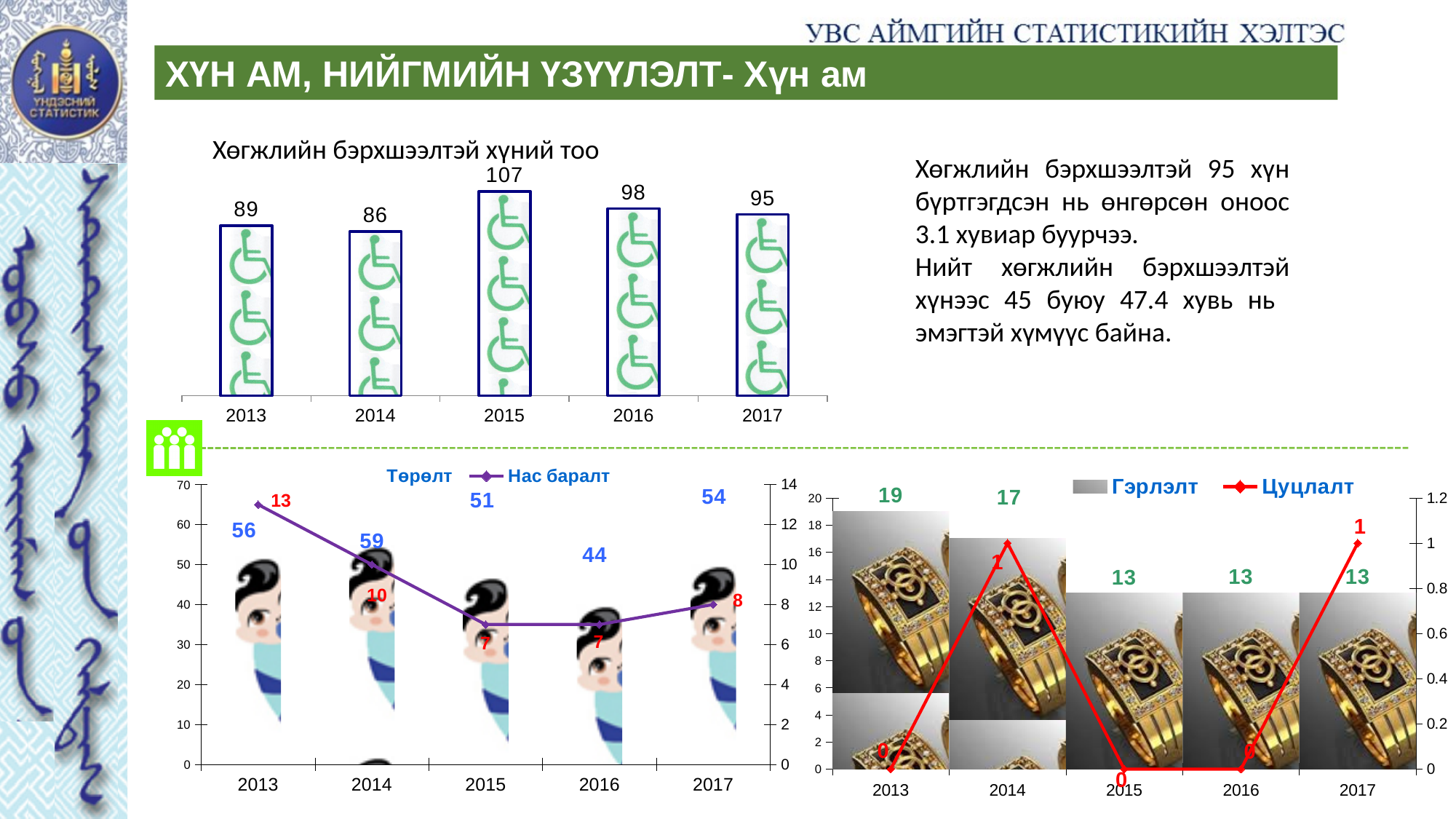
In the chart titled 'Хөгжлийн бэрхшээлтэй хүний тоо', what is the value for 2015? 107 In the chart titled 'Хөгжлийн бэрхшээлтэй хүний тоо', how many years are shown on the x axis? 5 In the chart titled 'Хөгжлийн бэрхшээлтэй хүний тоо', which year has the lowest value? 2014 In the bottom-left chart, what is the Төрөлт value for 2016? 44 In the bottom-left chart, how many series does the legend list? 2 In the chart titled 'Хөгжлийн бэрхшээлтэй хүний тоо', what is the difference between the values for 2015 and 2017? 12 In the bottom-left chart, what is the Нас баралт value for 2013? 13 In the bottom-right chart, what is the Гэрлэлт value for 2013? 19 In the bottom-right chart, is the Гэрлэлт value for 2014 larger or smaller than the value for 2015? larger In the chart titled 'Хөгжлийн бэрхшээлтэй хүний тоо', what kind of chart is it? bar chart In the bottom-right chart, what is the Цуцлалт value for 2017? 1 In the bottom-left chart, which year has the highest Төрөлт value? 2014